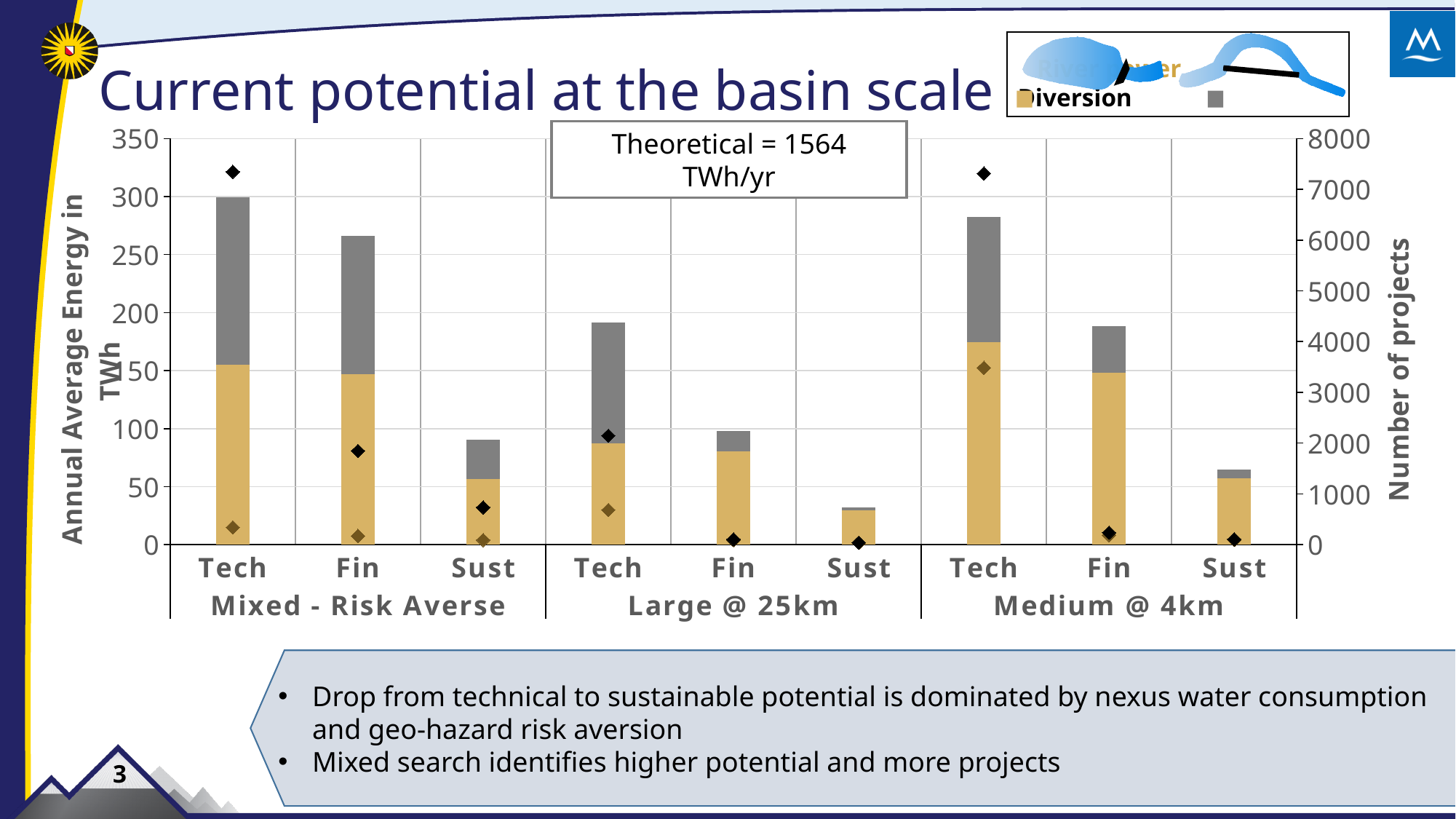
What kind of chart is shown on the slide? Stacked bar chart with diamond markers Which bar is the tallest in the chart? Tech in Mixed - Risk Averse What is the title of the slide containing the chart? Current potential at the basin scale Which bar is taller: Fin in Medium @ 4km or Fin in Large @ 25km? Fin in Medium @ 4km Is the total bar height for Fin in Large @ 25km greater or less than 150 TWh? less How many bars are plotted in the chart? 9 Which bar is taller: Tech in Mixed - Risk Averse or Tech in Large @ 25km? Tech in Mixed - Risk Averse Is the total bar height for Tech in Medium @ 4km greater or less than 250 TWh? greater Is the total bar height for Tech in Mixed - Risk Averse greater or less than 250 TWh? greater Which bar is the shortest in the chart? Sust in Large @ 25km Within the Mixed - Risk Averse group, do the bar heights rise or fall from Tech to Sust? fall